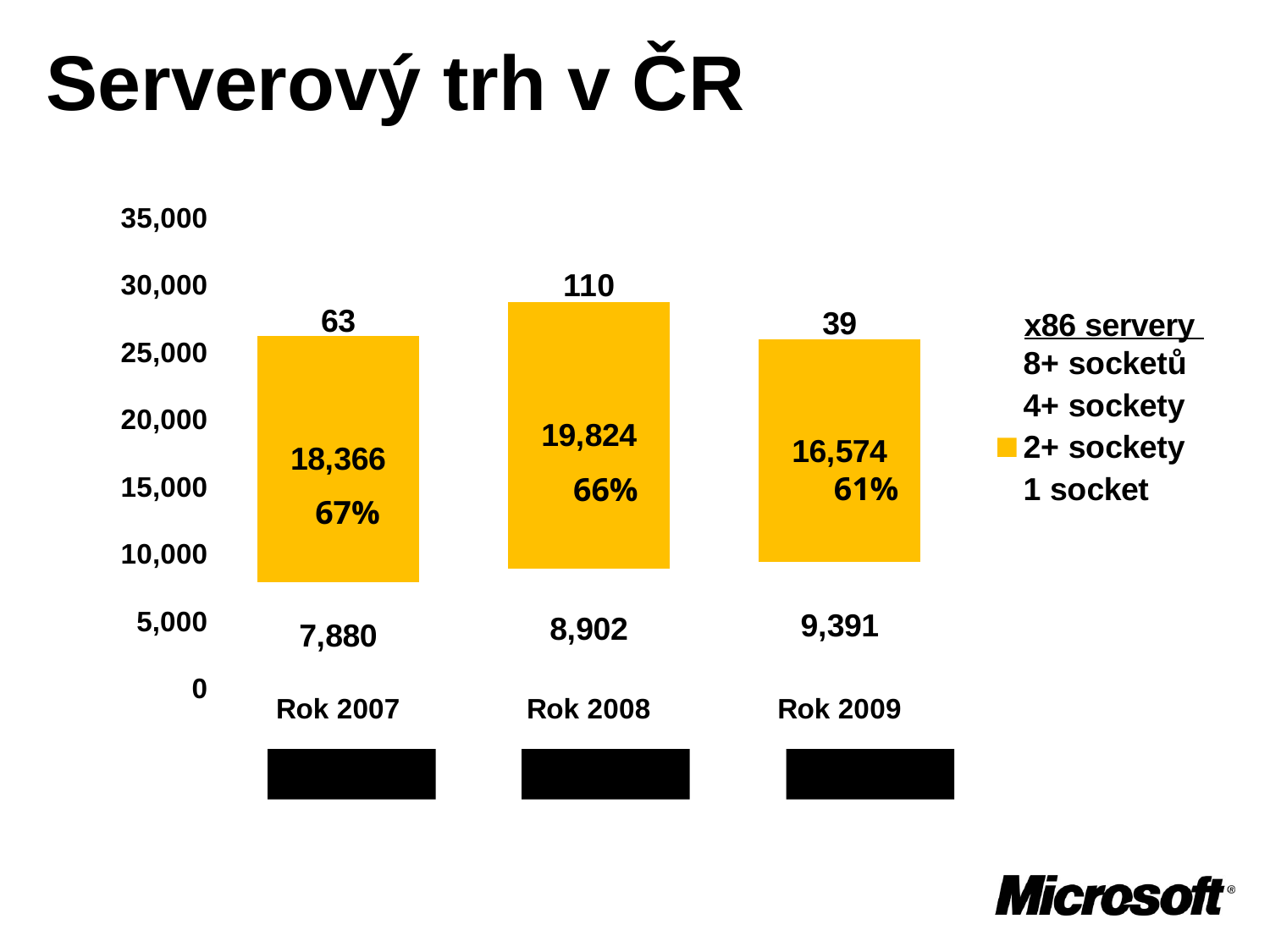
What is the difference between the 2+ sockety values for Rok 2008 and Rok 2009? 3,250 What percentage is printed in the 2+ sockety segment for Rok 2009? 61% How many series does the legend list? 4 What is the value of the 2+ sockety segment for Rok 2007? 18,366 Which year has the lowest value for the 2+ sockety segment? Rok 2009 What kind of chart is shown on the slide? Bar chart Which year has the highest value for the 2+ sockety segment? Rok 2008 Which is larger, the 2+ sockety value for Rok 2007 or for Rok 2009? Rok 2007 What is the difference between the 2+ sockety values for Rok 2008 and Rok 2007? 1,458 What is the underlined heading of the legend? x86 servery How many years are shown on the x axis of the chart? 3 What is the value of the 2+ sockety segment for Rok 2008? 19,824